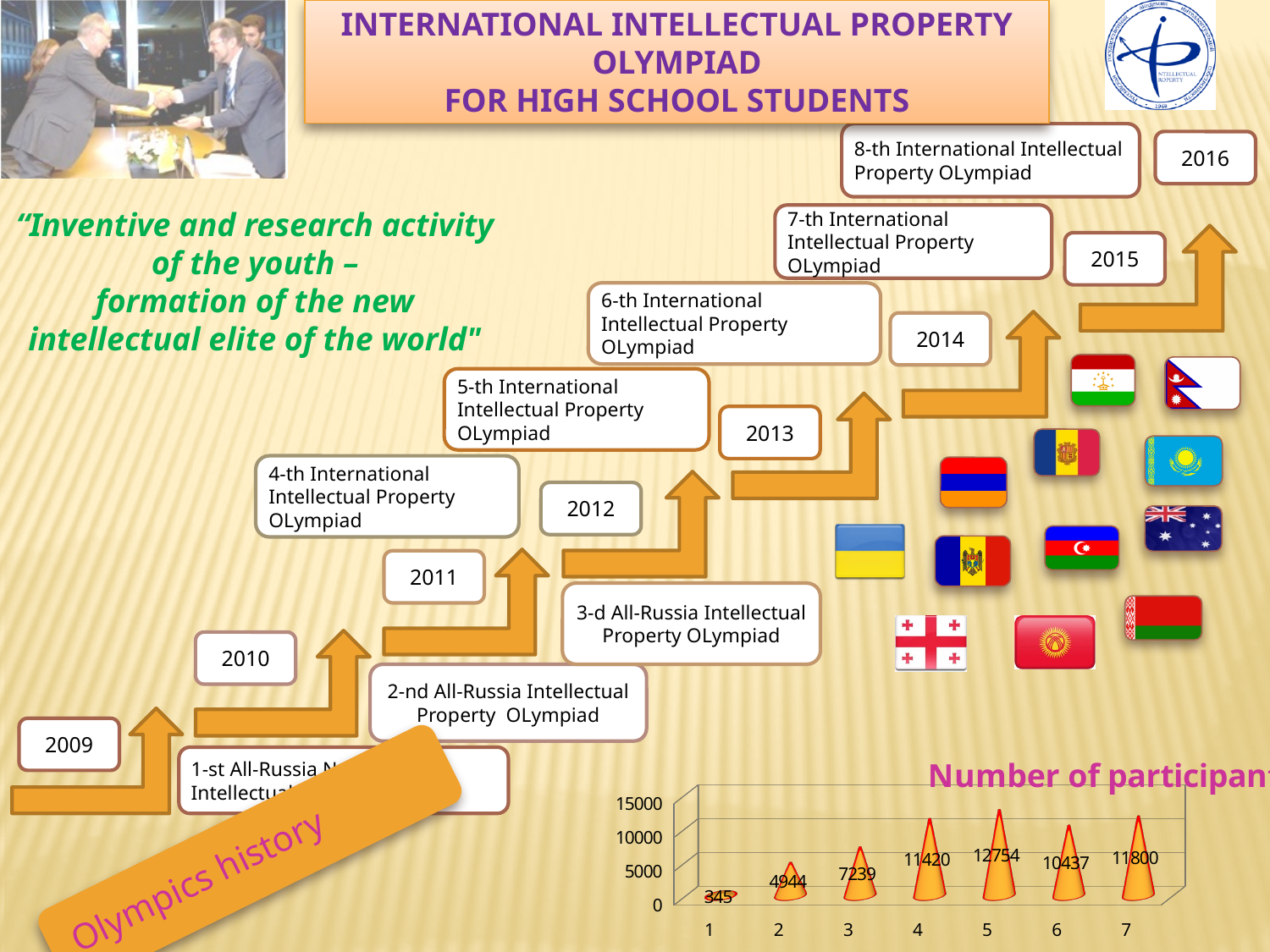
What is the value for category 1 in the Number of participants chart? 345 What is the value for category 4 in the Number of participants chart? 11420 What is the difference between the values for category 5 and category 6 in the Number of participants chart? 2317 Which category has the highest value in the Number of participants chart? 5 What is the difference between the values for category 2 and category 1 in the Number of participants chart? 4599 Which category has the lowest value in the Number of participants chart? 1 What is the value for category 7 in the Number of participants chart? 11800 What is the highest tick value shown on the vertical axis of the Number of participants chart? 15000 Which is larger in the Number of participants chart, the value for category 3 or category 6? 6 How many categories are shown on the x axis of the Number of participants chart? 7 What kind of chart is the Number of participants chart? bar chart Is the value for category 3 in the Number of participants chart greater or less than 10000? less